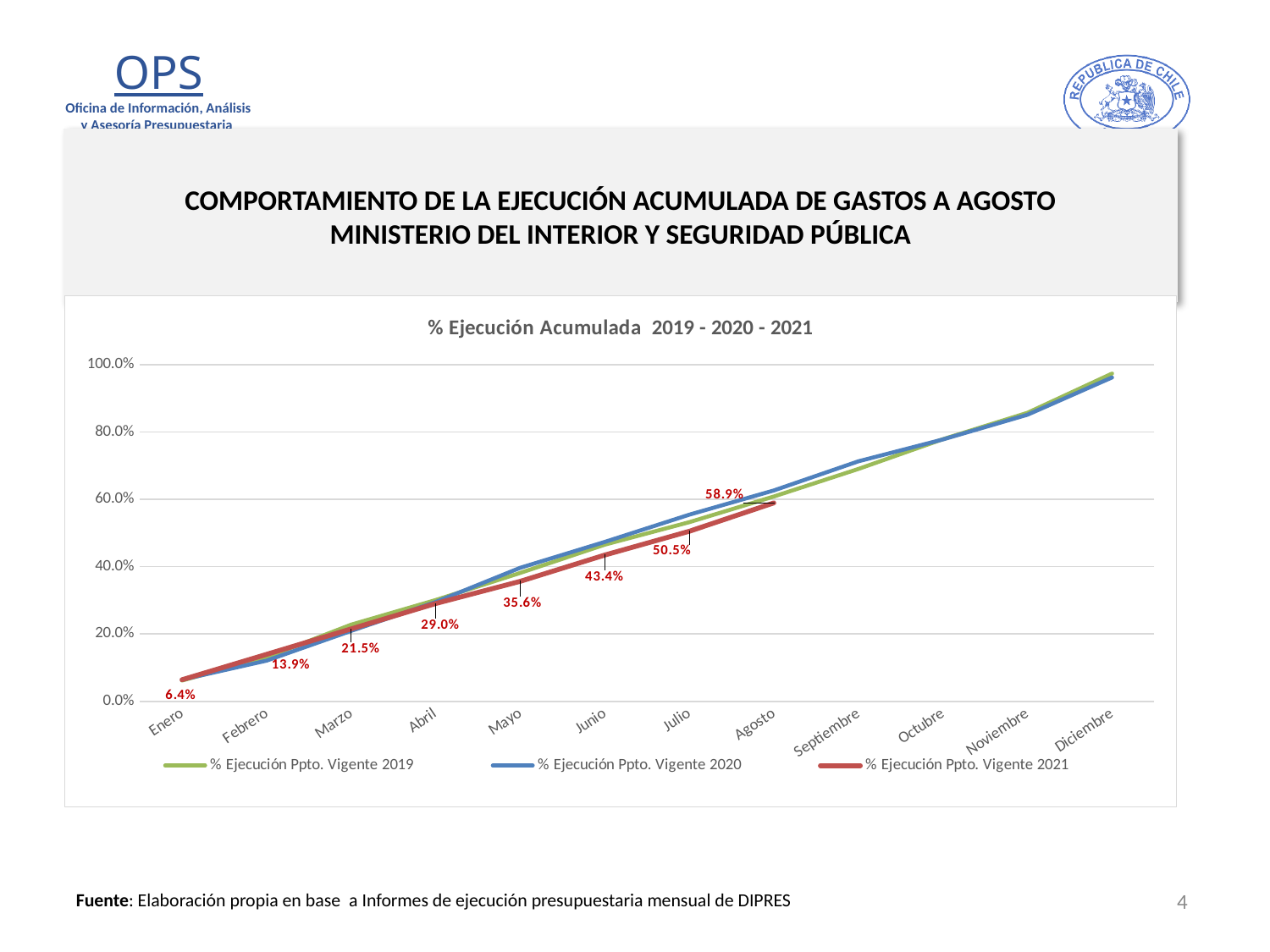
What is the value for % Ejecución Ppto. Vigente 2021 in Abril? 29.0% Which is larger, the 2021 value for Mayo or the 2021 value for Junio? Junio What is the value for % Ejecución Ppto. Vigente 2021 in Enero? 6.4% Is the value for % Ejecución Ppto. Vigente 2020 in Diciembre greater or less than 80.0%? greater What kind of chart is shown on the slide? line chart Does the % Ejecución Ppto. Vigente 2021 series rise or fall from Enero to Agosto? rise What is the value for % Ejecución Ppto. Vigente 2021 in Agosto? 58.9% Which month has the lowest value for % Ejecución Ppto. Vigente 2021? Enero How many months are shown on the x axis? 12 What is the difference between the 2021 values for Agosto and Julio? 8.4% What is the title of the chart? % Ejecución Acumulada 2019 - 2020 - 2021 How many series does the legend list? 3